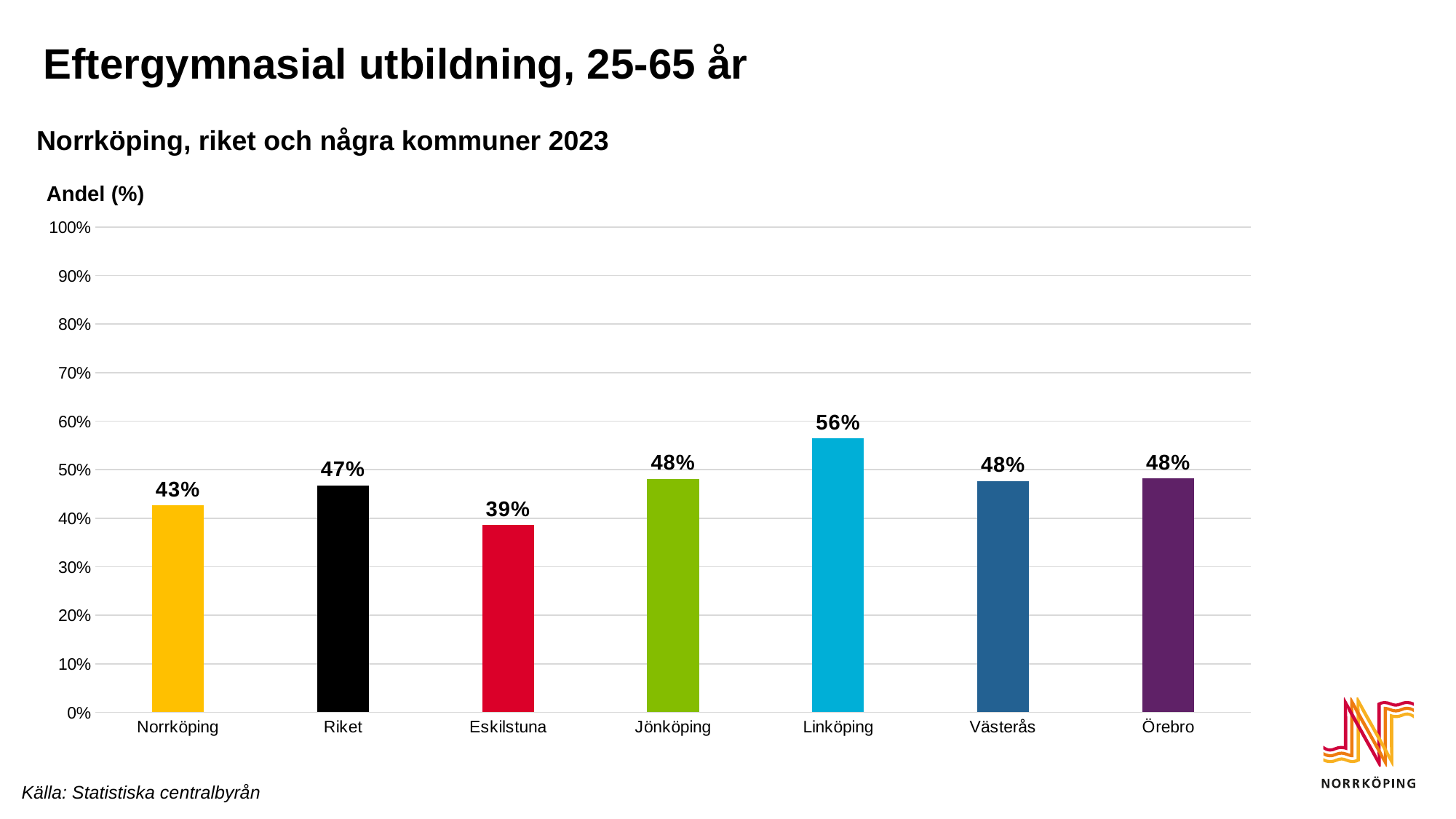
Which category has the highest value? Linköping Which category has the lowest value? Eskilstuna What is the value for Eskilstuna? 39% Which is larger, the value for Norrköping or the value for Riket? Riket What is the difference between the values for Linköping and Norrköping? 13% What is the value for Riket? 47% What is the label of the y axis? Andel (%) What is the difference between the values for Riket and Eskilstuna? 8% What is the value for Norrköping? 43% What is the value for Linköping? 56% What kind of chart is shown on the slide? Bar chart How many categories are shown on the x axis? 7